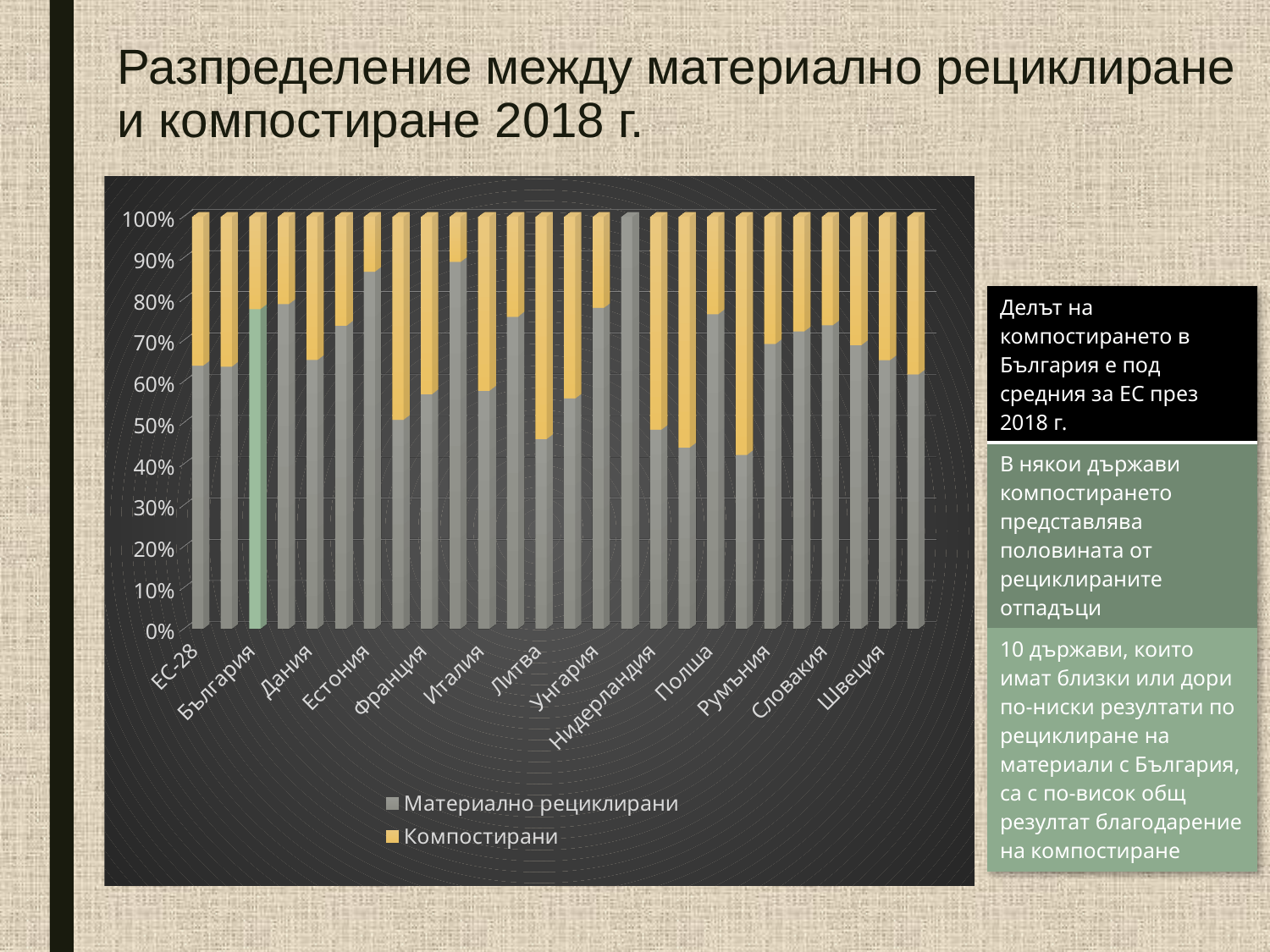
What kind of chart is shown on the slide? Stacked bar chart What is the title of the slide containing the chart? Разпределение между материално рециклиране и компостиране 2018 г. Is the share of Материално рециклирани for Швеция greater or less than 70%? less Is the share of Материално рециклирани for Румъния greater or less than 50%? greater What is the total of the stacked bar for България? 100% Which has the larger share of Материално рециклирани, България or ЕС-28? България What is the highest value shown on the vertical axis? 100% How many series does the legend list? 2 Which has the larger share of Компостирани, Румъния or България? Румъния Is the share of Материално рециклирани for България greater or less than 70%? greater What are the two series named in the legend? Материално рециклирани and Компостирани